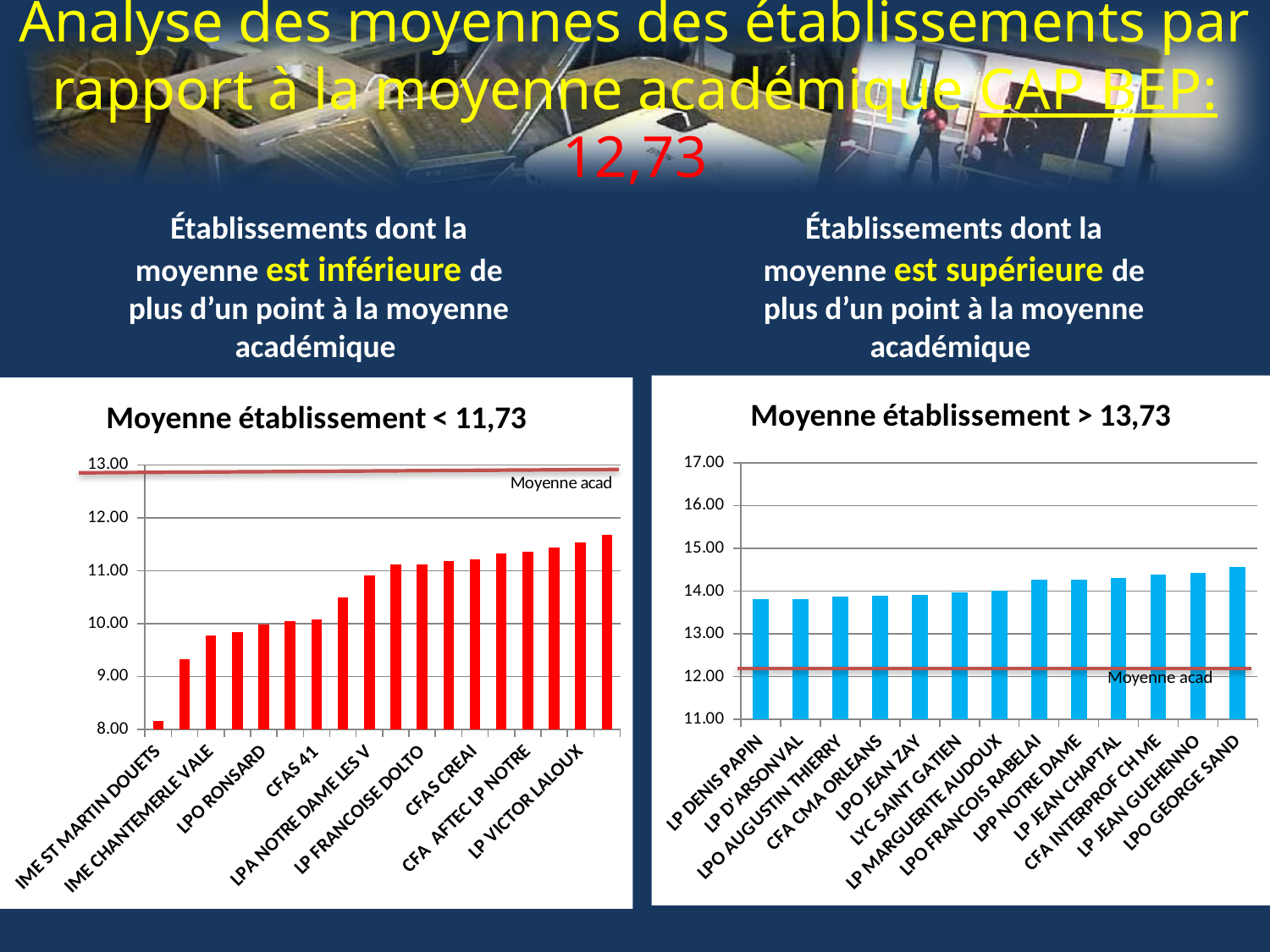
In the right chart "Moyenne établissement > 13,73", which establishment has the highest value? LPO GEORGE SAND How many establishments are shown in the right chart "Moyenne établissement > 13,73"? 13 In the left chart "Moyenne établissement < 11,73", which establishment has the lowest value? IME ST MARTIN DOUETS What kind of chart is the left chart titled "Moyenne établissement < 11,73"? bar chart In the right chart "Moyenne établissement > 13,73", do the bar values rise or fall from left to right? rise In the right chart "Moyenne établissement > 13,73", is the value for LPO GEORGE SAND greater or less than 14.00? greater In the left chart "Moyenne établissement < 11,73", which is larger, the value for IME ST MARTIN DOUETS or the value for IME CHANTEMERLE VALE? IME CHANTEMERLE VALE What colour are the bars in the right chart "Moyenne établissement > 13,73"? blue In the right chart "Moyenne établissement > 13,73", is the value for LPP NOTRE DAME greater or less than 14.00? greater In the right chart "Moyenne établissement > 13,73", which is larger, the value for LPO GEORGE SAND or the value for LP DENIS PAPIN? LPO GEORGE SAND In the left chart "Moyenne établissement < 11,73", is the value for IME CHANTEMERLE VALE greater or less than 10.00? less